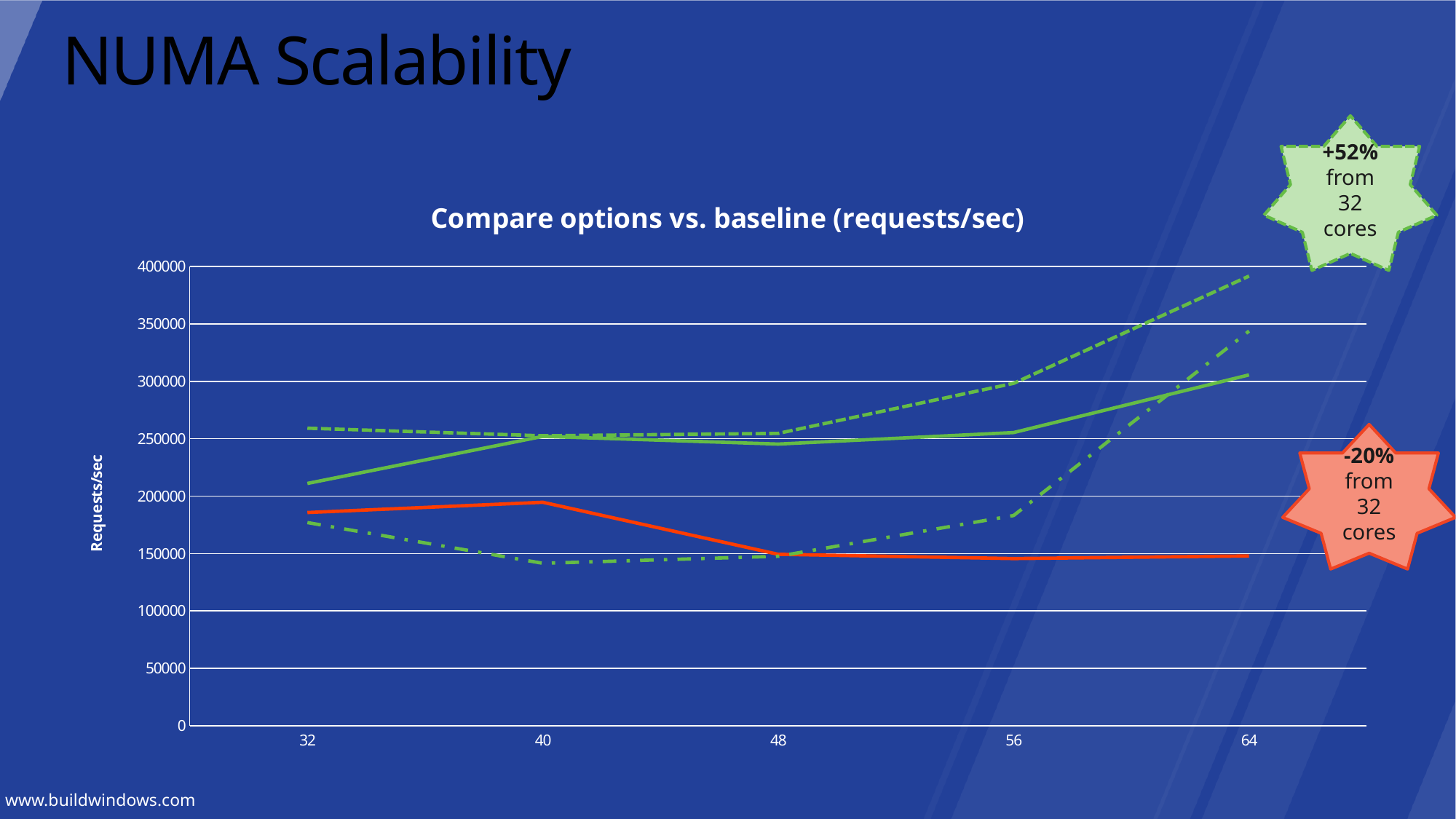
Is the value of the green dash-dot line at 40 cores greater or less than 200000? less Which line has the highest value at 64 cores? the green dashed line Does the red solid line rise or fall overall from 32 cores to 64 cores? fall What kind of chart is shown on the slide? line chart Which line has the lowest value at 64 cores? the red solid line Is the value of the red solid line at 32 cores greater or less than 200000? less Is the value of the green dashed line at 64 cores greater or less than 350000? greater What is the title of the chart? Compare options vs. baseline (requests/sec) How many core-count points are plotted along the x axis? 5 What is the label on the vertical axis? Requests/sec